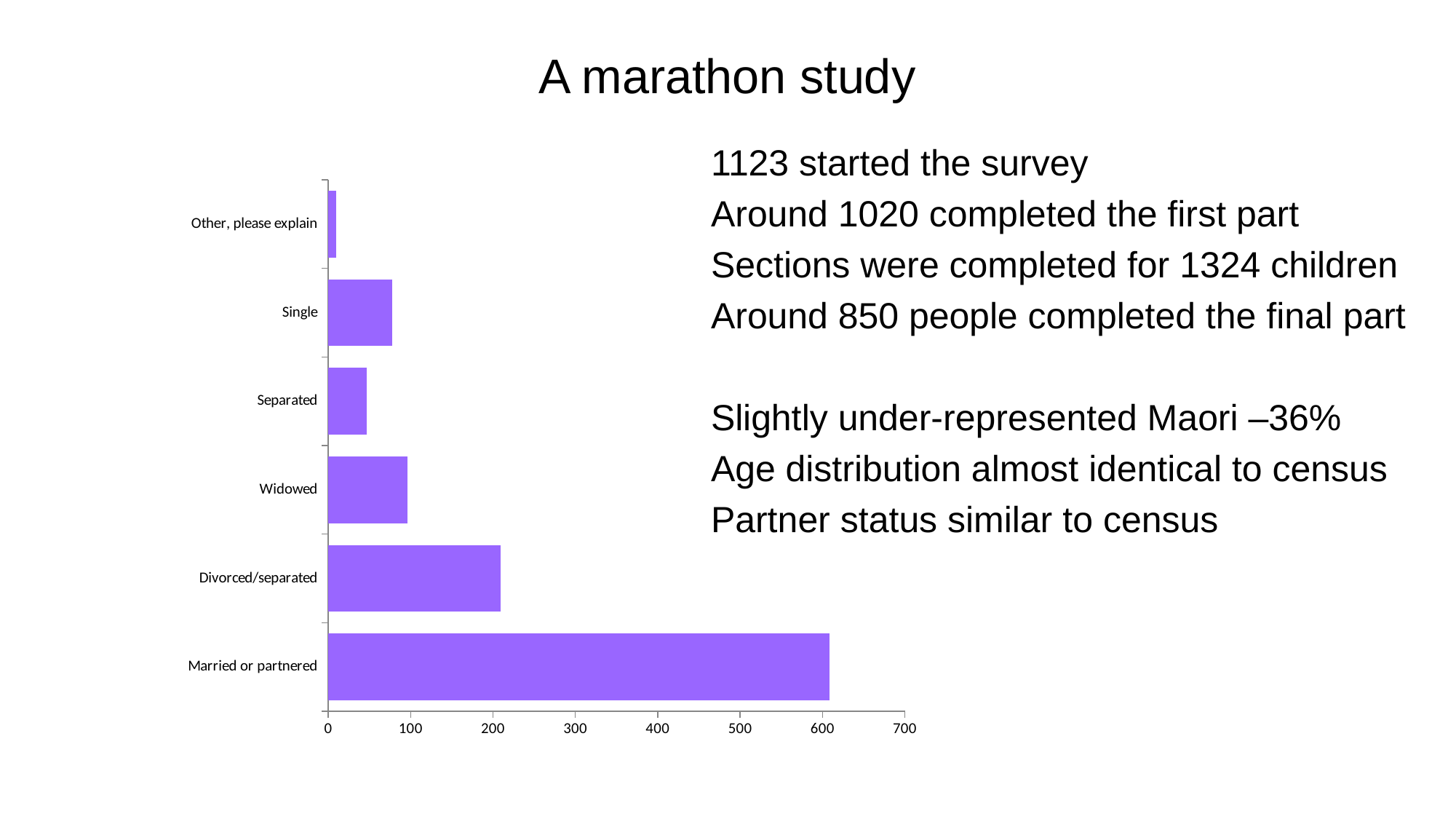
What kind of chart is shown on the slide? bar chart Which category has the lowest value in the bar chart? Other, please explain Which category has the highest value in the bar chart? Married or partnered Which is larger, the value for Single or the value for Separated? Single How many categories are shown in the bar chart? 6 Is the value for Single greater or less than 100? less Is the value for Married or partnered greater or less than 500? greater Is the value for Widowed greater or less than 50? greater Which is larger, the value for Divorced/separated or the value for Widowed? Divorced/separated What colour are the bars in the chart? purple